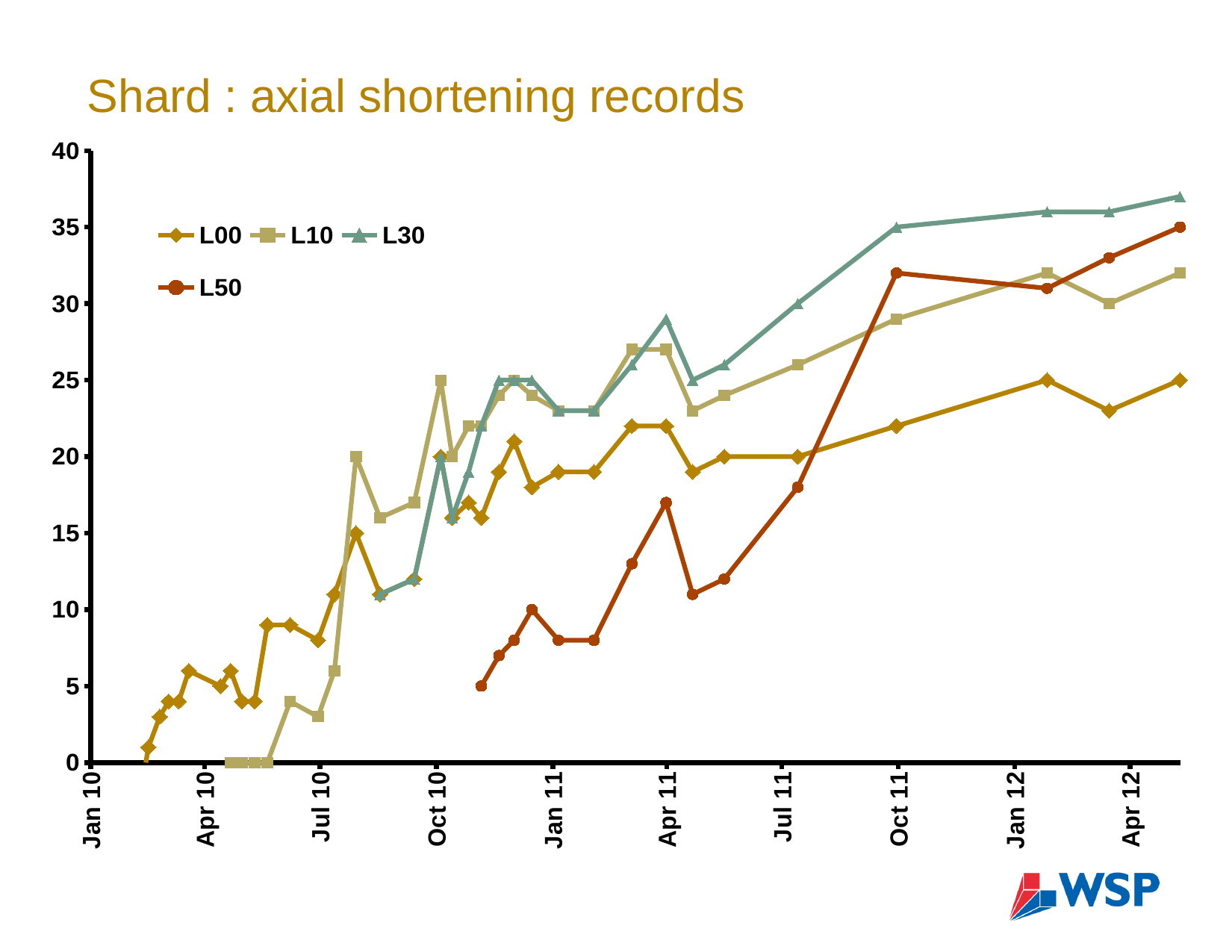
Is the value for L30 at Apr 12 greater or less than 35? greater Which series begins its record latest along the x axis? L50 Which series has the lowest value at the right end of the chart? L00 At Jan 11, which series has the larger value, L10 or L50? L10 How many series does the legend list? 4 Is the value for L10 at Jul 10 greater or less than 10? less What is the title of the chart? Shard : axial shortening records At Apr 12, which series has the larger value, L30 or L00? L30 Is the value for L00 at Apr 12 greater or less than 25? less Which series reaches the highest value at the right end of the chart? L30 What kind of chart is shown on the slide? line chart